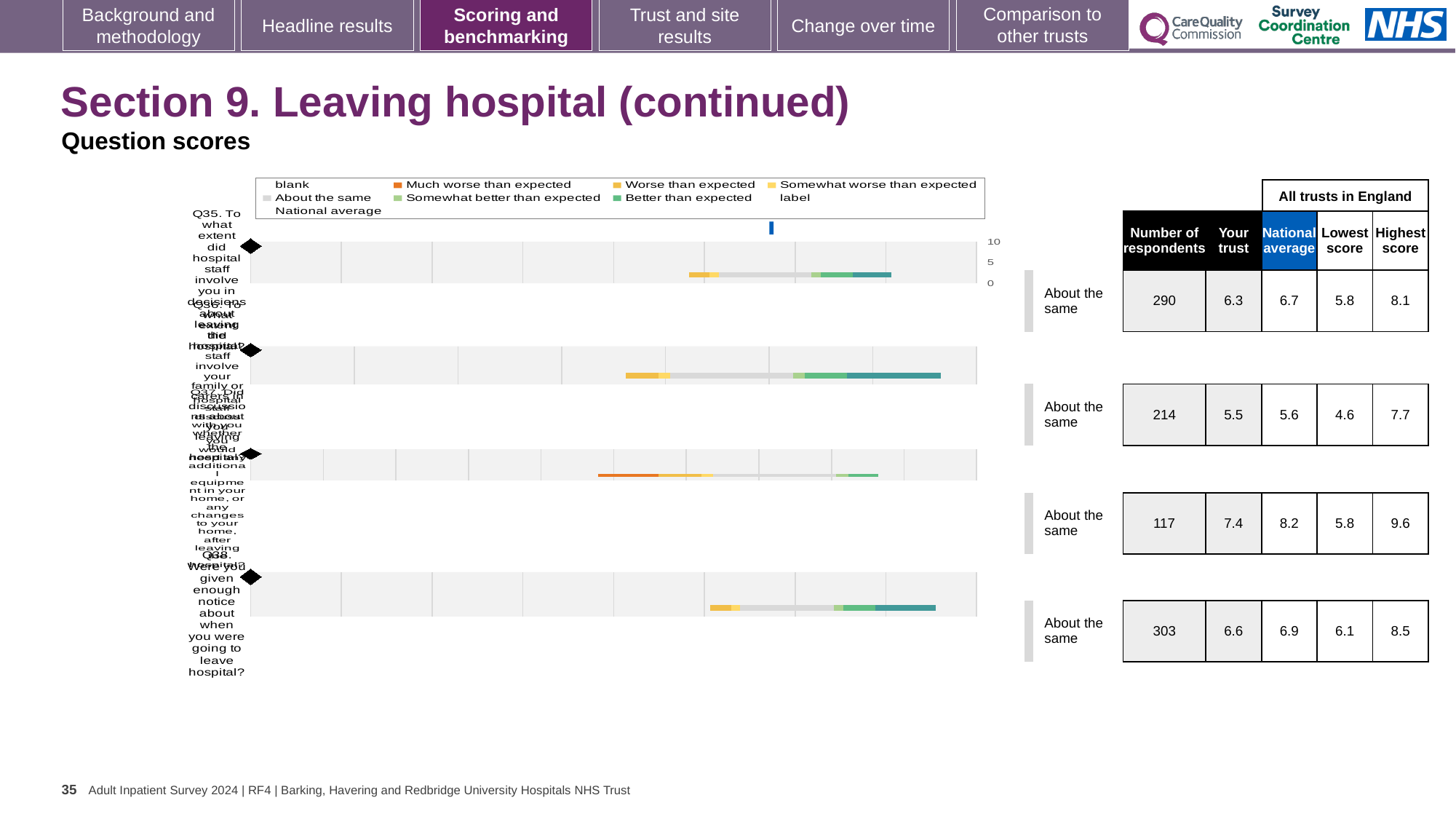
What kind of chart is used to show the question scores on this slide? bar chart What is the national average for Q38 (given enough notice about when you were going to leave hospital)? 6.9 Which row of the table has the highest 'Your trust' score? The third row (117 respondents), 7.4 For Q35, which is larger: the 'Your trust' score or the national average? National average What is the highest score among all trusts in England for Q38 (given enough notice about leaving hospital)? 8.5 How many entries does the chart legend list? 9 What benchmark category is shown for Q38 (given enough notice about leaving hospital)? About the same How many questions (bars) are plotted in the chart? 4 What is the number of respondents for Q35 (involving you in decisions about leaving hospital)? 290 In the chart legend, which category is shown in dark orange? Much worse than expected What is the 'Your trust' score for Q35 (involving you in decisions about leaving hospital)? 6.3 For Q35, what is the difference between the national average (6.7) and the 'Your trust' score (6.3)? 0.4